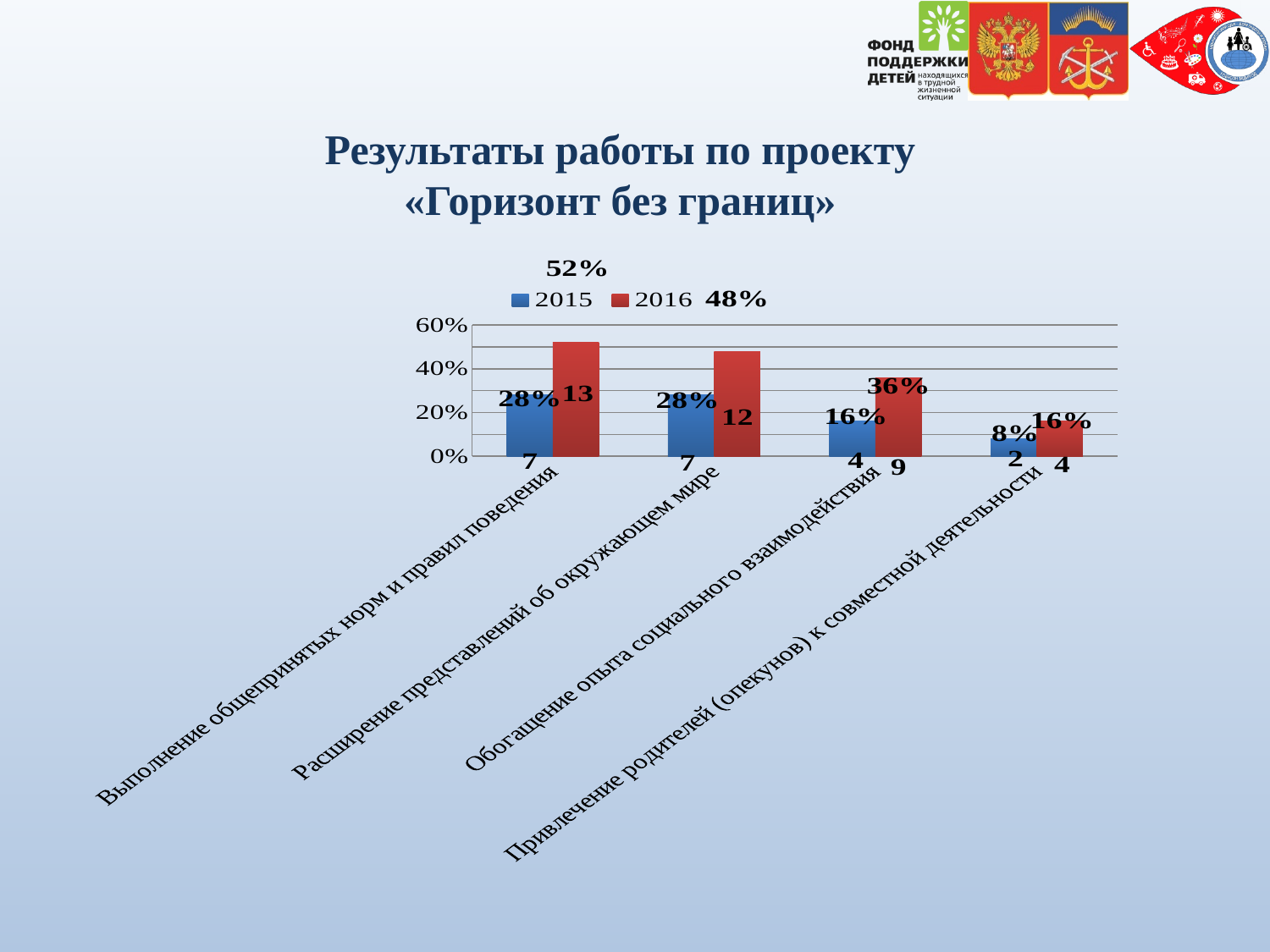
What is the 2016 value for «Выполнение общепринятых норм и правил поведения»? 52% What is the 2015 value for «Обогащение опыта социального взаимодействия»? 16% What kind of chart is shown on the slide? Bar chart Is the 2016 value for «Расширение представлений об окружающем мире» greater or less than 40%? greater What is the 2016 value for «Привлечение родителей (опекунов) к совместной деятельности»? 16% Which category has the highest 2016 value? Выполнение общепринятых норм и правил поведения What is the difference between the 2016 and 2015 values for «Расширение представлений об окружающем мире»? 20% How many series does the legend list? 2 Which series is shown in red in the legend? 2016 Which is larger for «Обогащение опыта социального взаимодействия»: the 2015 value or the 2016 value? 2016 Which category has the lowest 2015 value? Привлечение родителей (опекунов) к совместной деятельности How many categories are shown on the x axis? 4